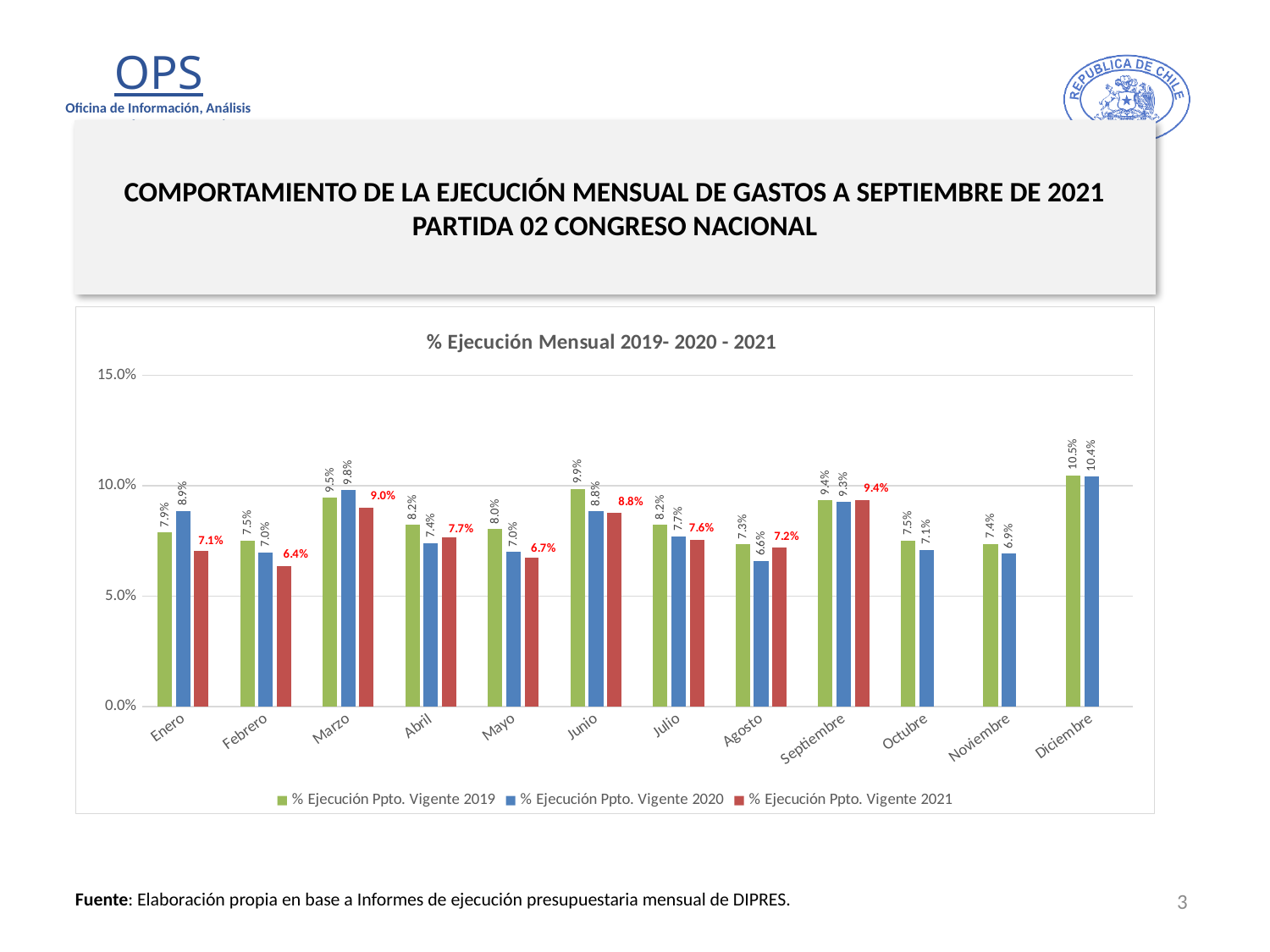
What is the value for % Ejecución Ppto. Vigente 2019 in Diciembre? 10.5% How many months are shown on the x axis? 12 How many series does the legend list? 3 Which month has the highest value for % Ejecución Ppto. Vigente 2019? Diciembre What kind of chart is shown on the slide? Bar chart Which month has the highest value for % Ejecución Ppto. Vigente 2021? Septiembre Which month has the lowest value for % Ejecución Ppto. Vigente 2021? Febrero What is the value for % Ejecución Ppto. Vigente 2020 in Enero? 8.9% In Abril, which is larger: the 2020 value or the 2021 value? 2021 (7.7%) What is the value for % Ejecución Ppto. Vigente 2021 in Marzo? 9.0% What is the difference between the 2020 and 2021 values in Enero? 1.8 percentage points What is the difference between the 2019 and 2021 values in Junio? 1.1 percentage points